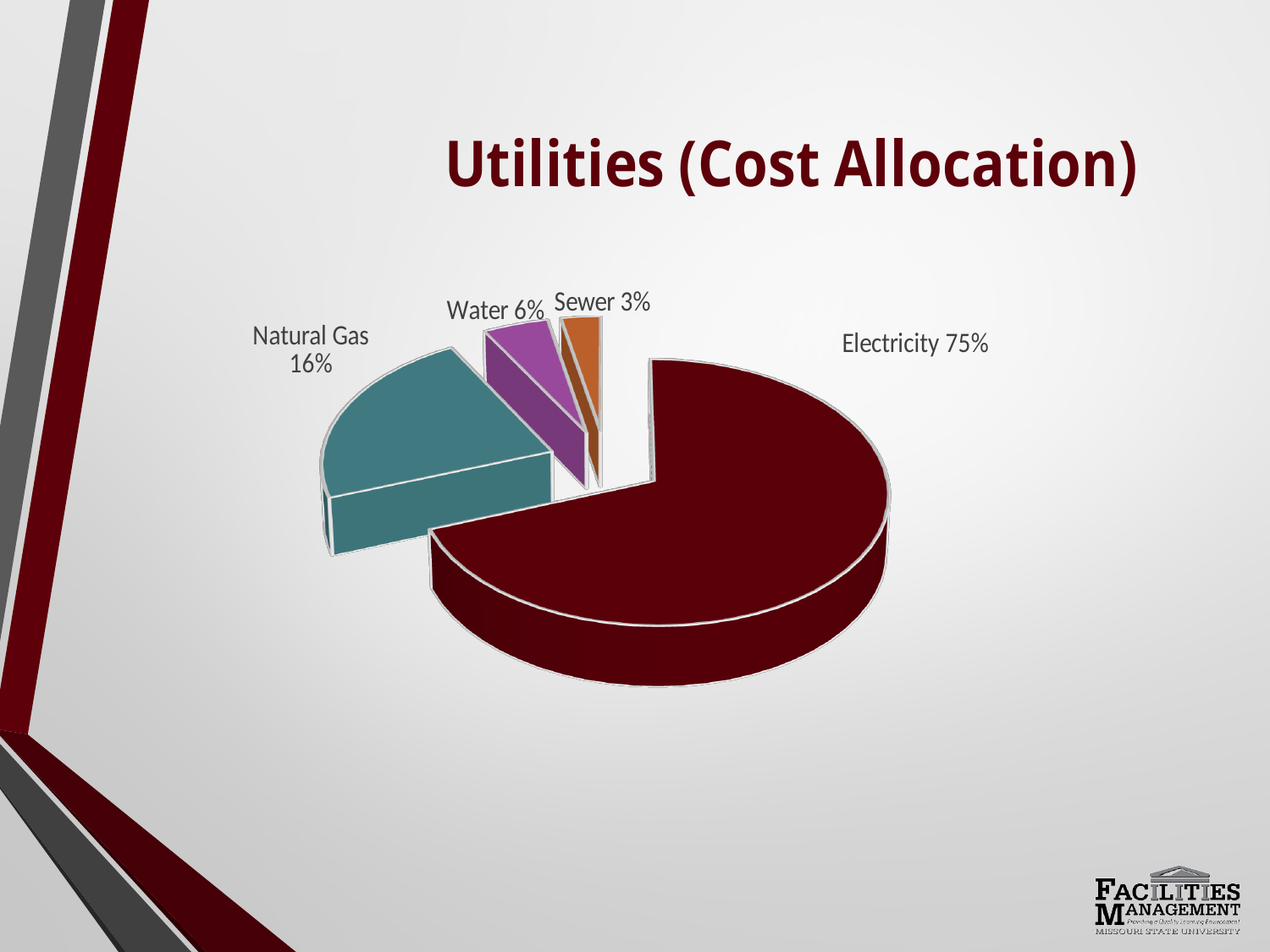
What is the difference in percentage points between Electricity and Natural Gas? 59 What share of utility cost is allocated to Water? 6% Which is larger, the share for Water or the share for Sewer? Water What share of utility cost is allocated to Electricity? 75% How many categories are shown in the pie chart? 4 What share of utility cost is allocated to Natural Gas? 16% What share of utility cost is allocated to Sewer? 3% What is the title of the chart? Utilities (Cost Allocation) Which category has the largest share of the pie? Electricity What kind of chart is shown on the slide? Pie chart Which category has the smallest share of the pie? Sewer What colour is the Electricity slice? Dark red (maroon)